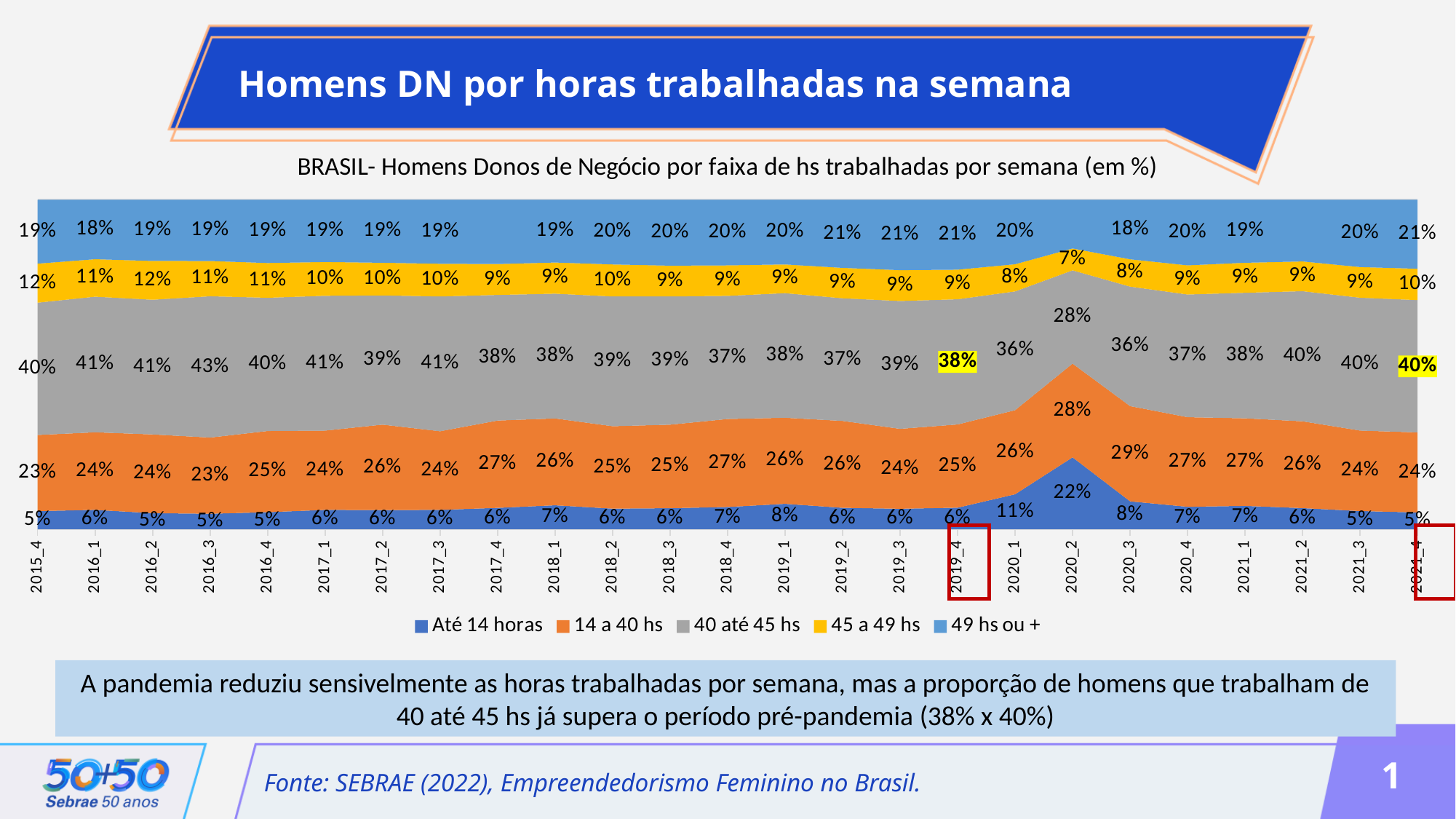
What is the difference between the '40 até 45 hs' value in 2021_4 and in 2019_4? 2 percentage points What is the title of the chart? BRASIL- Homens Donos de Negócio por faixa de hs trabalhadas por semana (em %) How many series does the legend list? 5 What is the value for 'Até 14 horas' in 2020_2? 22% What is the value for '45 a 49 hs' in 2015_4? 12% What is the value for '40 até 45 hs' in 2021_4? 40% In which quarter is the 'Até 14 horas' series highest? 2020_2 What is the value for '49 hs ou +' in 2019_2? 21% In which quarter is the '40 até 45 hs' series lowest? 2020_2 What kind of chart is shown on the slide? Stacked area chart How many quarters are shown along the x axis? 25 Which is larger for '14 a 40 hs': the value in 2020_3 or in 2019_4? 2020_3